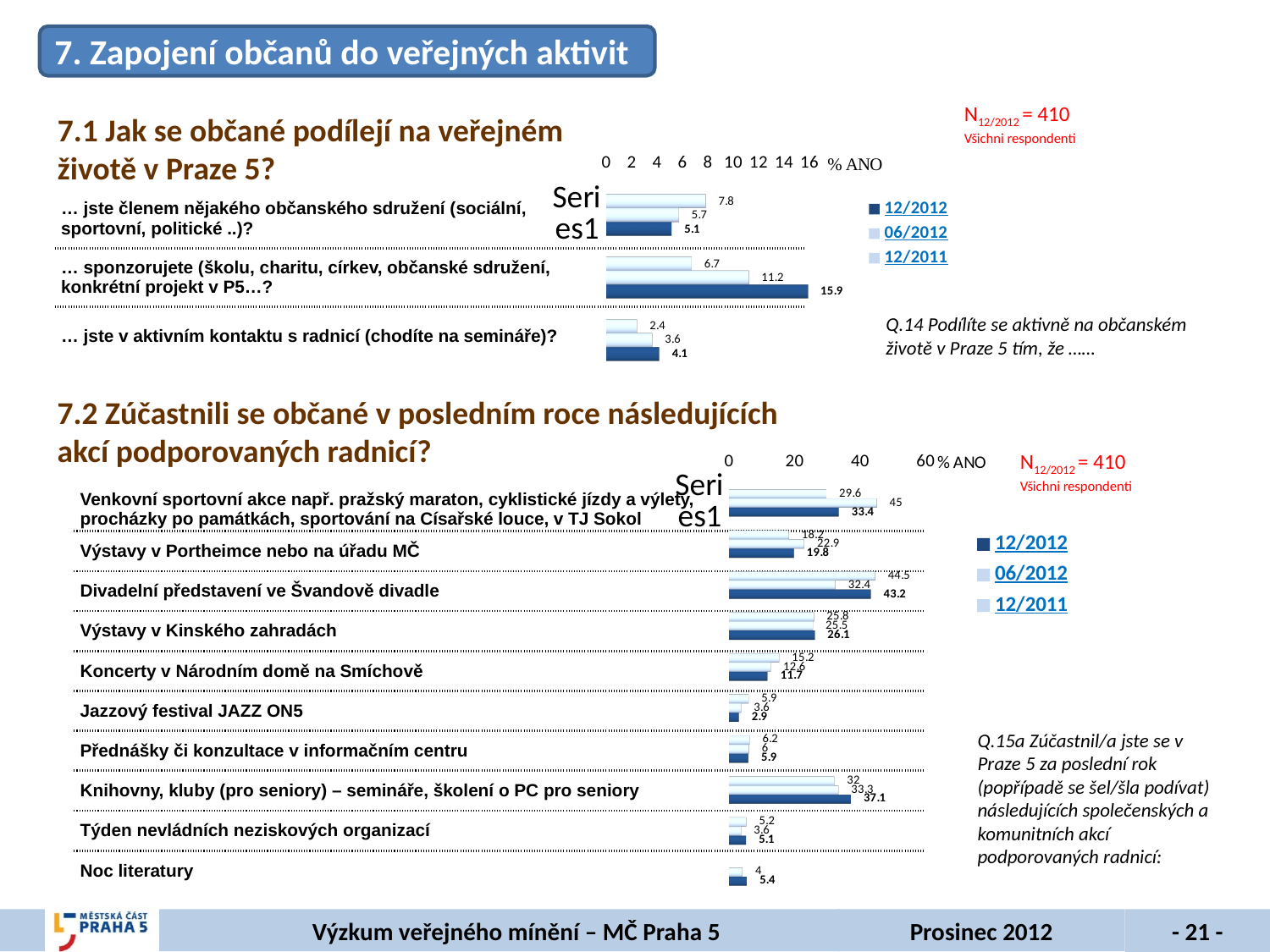
How many series does the legend of the top chart (7.1) list? 3 How many categories are shown in the bottom chart (7.2)? 10 In the bottom chart (7.2), which category has the lowest 12/2012 value? Jazzový festival JAZZ ON5 In the bottom chart (7.2), what is the 12/2012 value for Divadelní představení ve Švandově divadle? 43.2 In the top chart (7.1), what is the difference between the 12/2012 and 12/2011 values for sponsoring? 9.2 In the bottom chart (7.2), what is the 06/2012 value for Venkovní sportovní akce? 45 In the bottom chart (7.2), is the 12/2012 value for Divadelní představení ve Švandově divadle greater or less than 40? greater In the top chart (7.1), what is the 12/2011 value for being a member of a civic association? 7.8 What kind of chart is the top chart (7.1)? bar chart In the top chart (7.1), which category has the highest 12/2012 value? … sponzorujete (školu, charitu, církev, občanské sdružení, konkrétní projekt v P5…)? In the top chart (7.1), what is the 12/2012 value for sponsoring a school, charity, church, civic association or project in P5? 15.9 In the bottom chart (7.2), which has the larger 12/2012 value: Knihovny, kluby (pro seniory) or Venkovní sportovní akce? Knihovny, kluby (pro seniory)